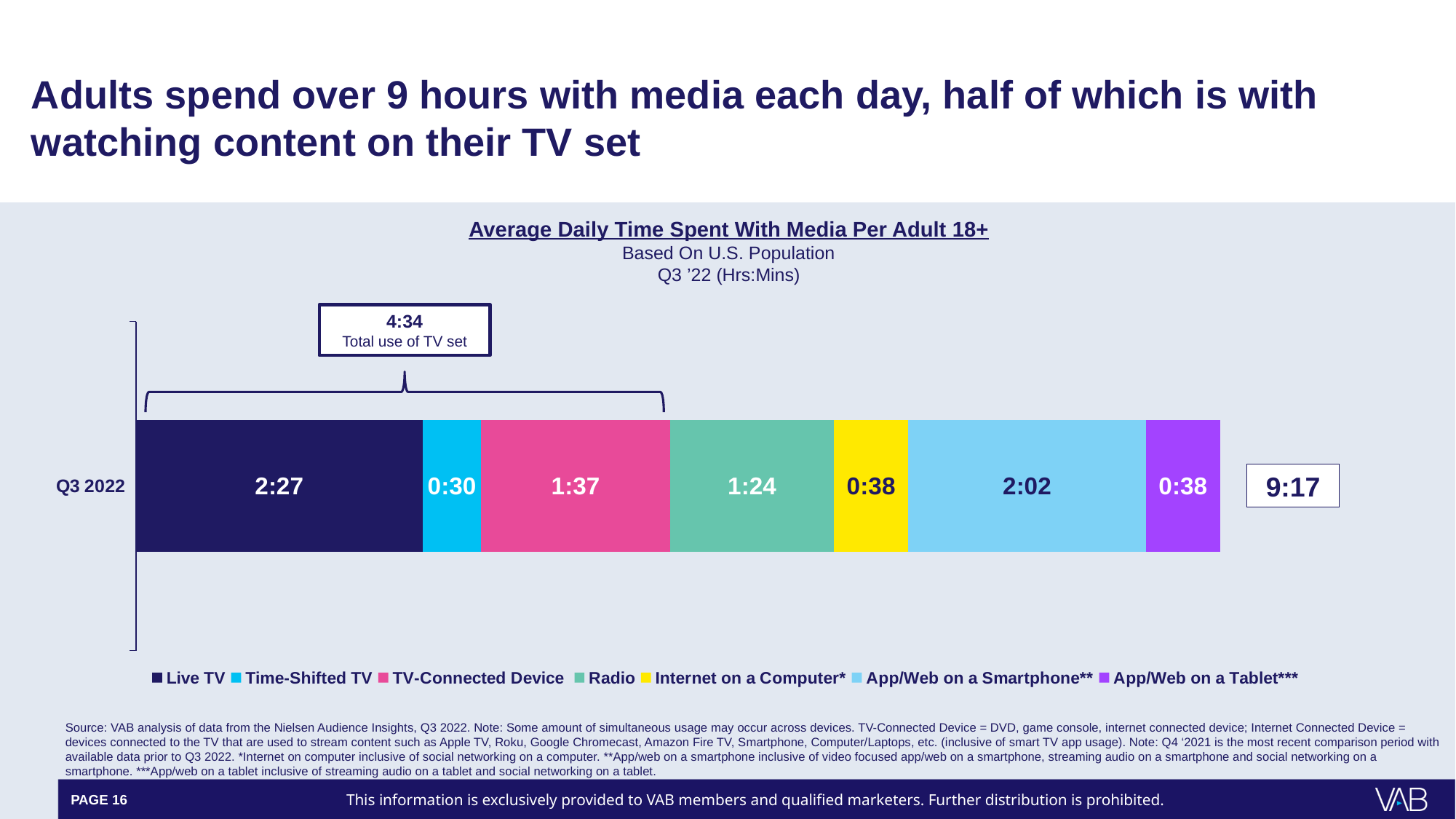
What kind of chart is shown on the slide? Stacked bar chart What is the value for App/Web on a Smartphone**? 2:02 What is the value for Live TV in the stacked bar? 2:27 What is the difference between the Live TV value and the App/Web on a Smartphone** value? 0:25 Which series has the smallest value in the Q3 2022 bar? Time-Shifted TV Which is larger, the value for Radio or the value for TV-Connected Device? TV-Connected Device How many series does the legend list? 7 What is the value for Radio? 1:24 What is the total use of TV set shown in the callout above the bar? 4:34 What is the total of the Q3 2022 stacked bar? 9:17 Which series has the largest value in the Q3 2022 bar? Live TV What is the value for TV-Connected Device? 1:37